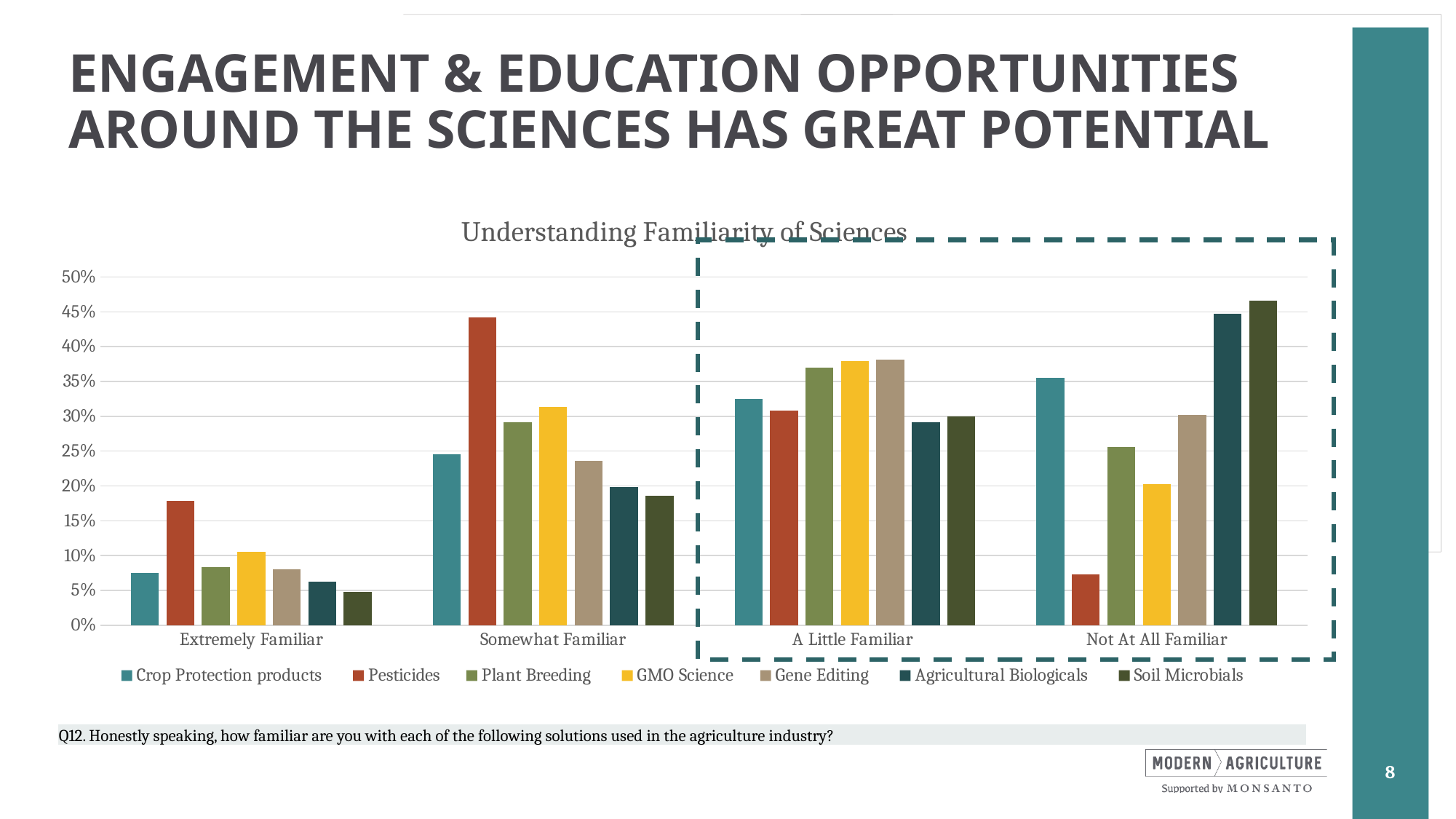
Is the value for Agricultural Biologicals in the Not At All Familiar group greater or less than 40%? greater In the Not At All Familiar group, which is larger: Crop Protection products or Pesticides? Crop Protection products How many series does the legend list? 7 In the Not At All Familiar group, which series has the lowest bar? Pesticides In the Somewhat Familiar group, which series has the highest bar? Pesticides How many familiarity categories are shown on the x axis? 4 What kind of chart is shown on the slide? bar chart In the Extremely Familiar group, which series has the highest bar? Pesticides Is the value for GMO Science in the Not At All Familiar group greater or less than 25%? less What is the title of the chart? Understanding Familiarity of Sciences Is the value for Pesticides in the Somewhat Familiar group greater or less than 40%? greater In the Extremely Familiar group, which series has the lowest bar? Soil Microbials